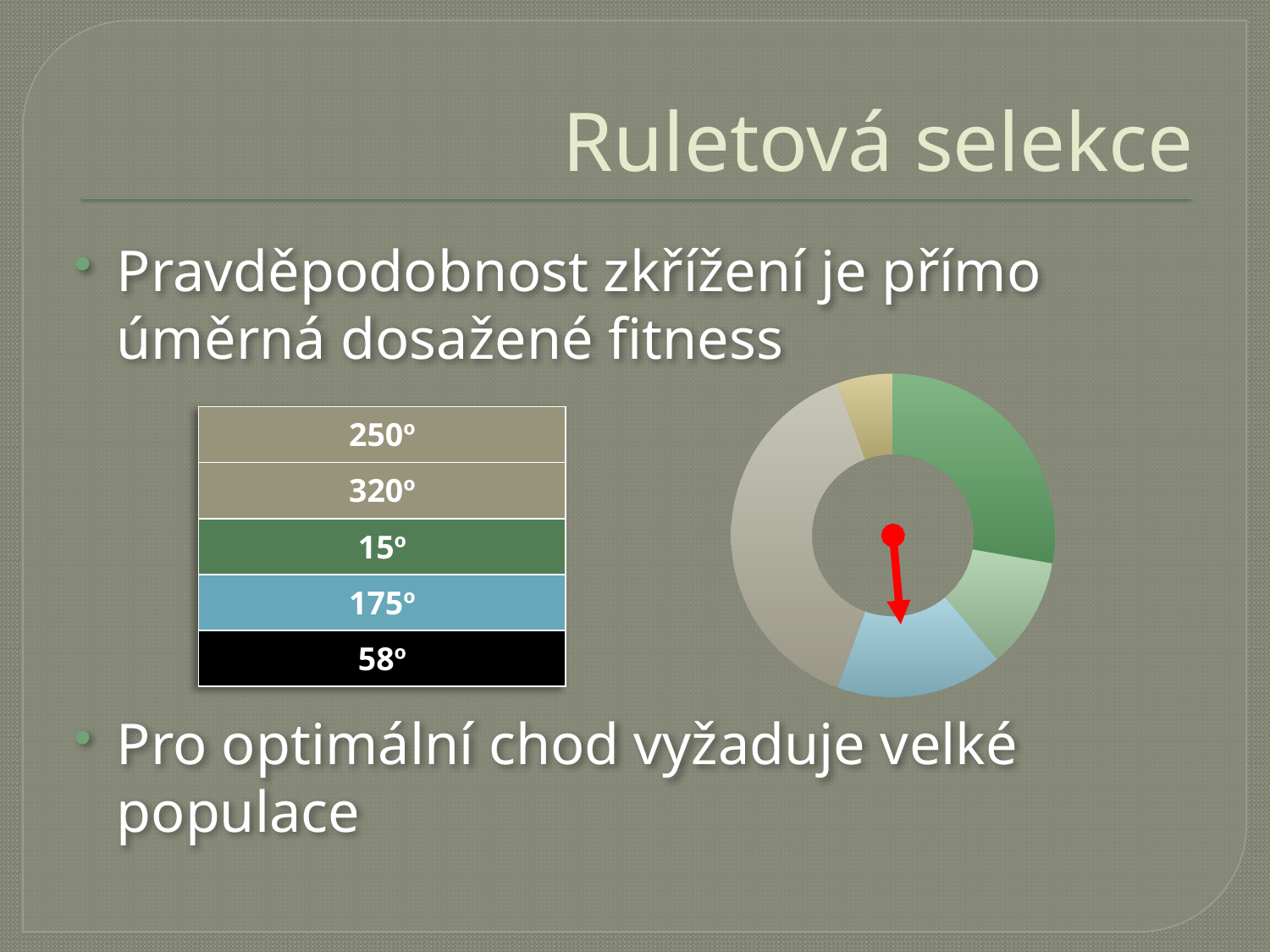
Which slice of the doughnut chart is the smallest? The yellow slice In the doughnut chart, which is larger: the grey slice or the dark green slice? The grey slice Does the doughnut chart display a legend? No How many slices does the doughnut chart have? 5 In the doughnut chart, which is larger: the yellow slice or the light green slice? The light green slice In the doughnut chart, which is larger: the dark green slice or the blue slice? The dark green slice Which slice of the doughnut chart is the largest? The grey (beige) slice Which slice of the doughnut chart does the red arrow point to? The blue slice What kind of chart is shown on the slide? Doughnut chart